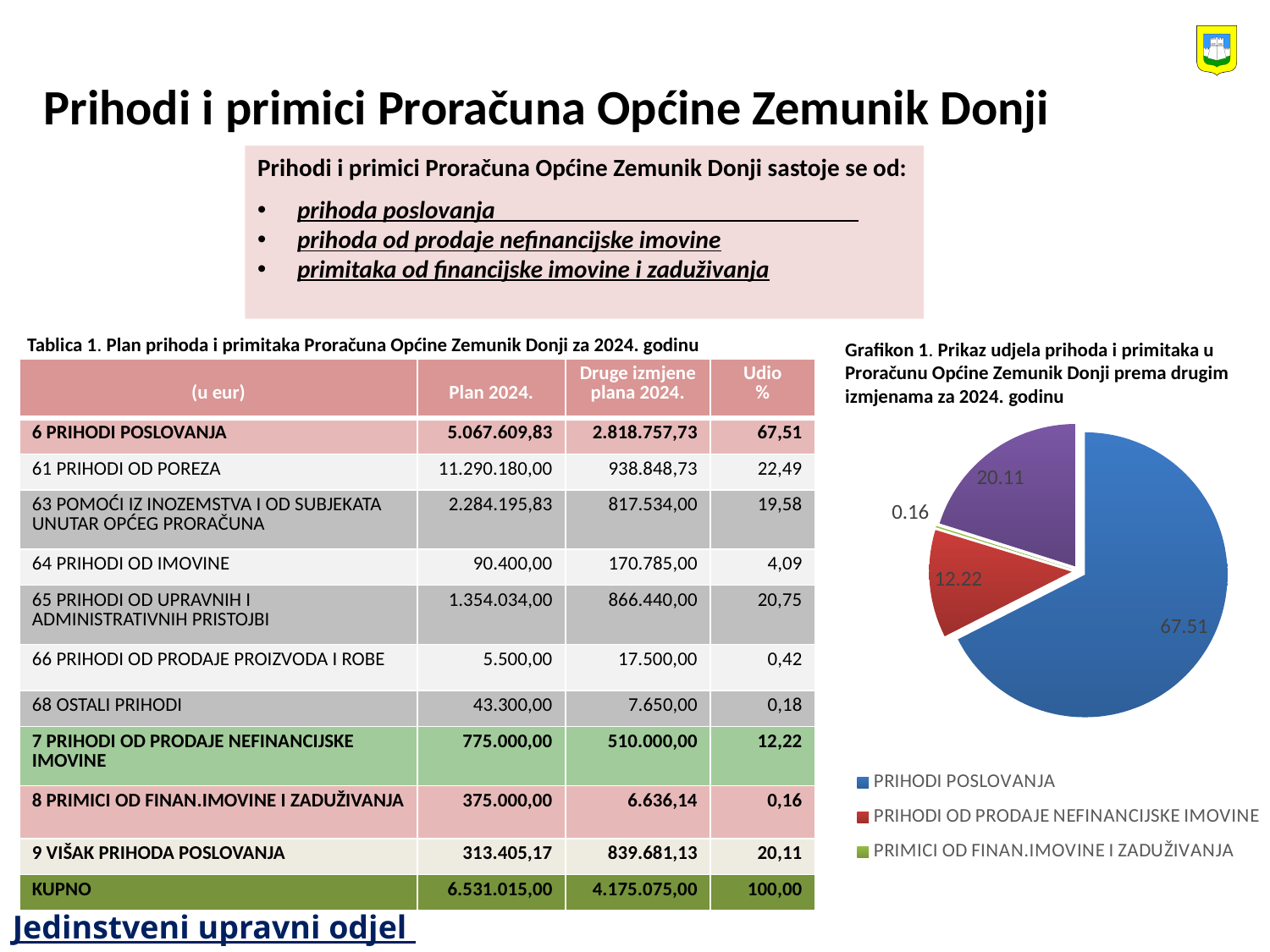
In Grafikon 1, which legend category has the largest slice of the pie? PRIHODI POSLOVANJA In Grafikon 1, what share is shown for PRIHODI POSLOVANJA? 67.51 In Grafikon 1, which is larger: the slice for PRIHODI POSLOVANJA or the slice for PRIHODI OD PRODAJE NEFINANCIJSKE IMOVINE? PRIHODI POSLOVANJA In Grafikon 1, what is the difference between the share for PRIHODI POSLOVANJA and the share for PRIHODI OD PRODAJE NEFINANCIJSKE IMOVINE? 55.29 In Grafikon 1, what colour is the slice for PRIHODI POSLOVANJA? Blue How many slices does the pie in Grafikon 1 have? 4 In Grafikon 1, which legend category has the smallest slice of the pie? PRIMICI OD FINAN.IMOVINE I ZADUŽIVANJA In Grafikon 1, what is the difference between the share for PRIHODI OD PRODAJE NEFINANCIJSKE IMOVINE and the share for PRIMICI OD FINAN.IMOVINE I ZADUŽIVANJA? 12.06 In Grafikon 1, what share is shown for PRIMICI OD FINAN.IMOVINE I ZADUŽIVANJA? 0.16 How many entries does the legend of Grafikon 1 list? 3 In Grafikon 1, what share is shown for PRIHODI OD PRODAJE NEFINANCIJSKE IMOVINE? 12.22 What type of chart is Grafikon 1? Pie chart